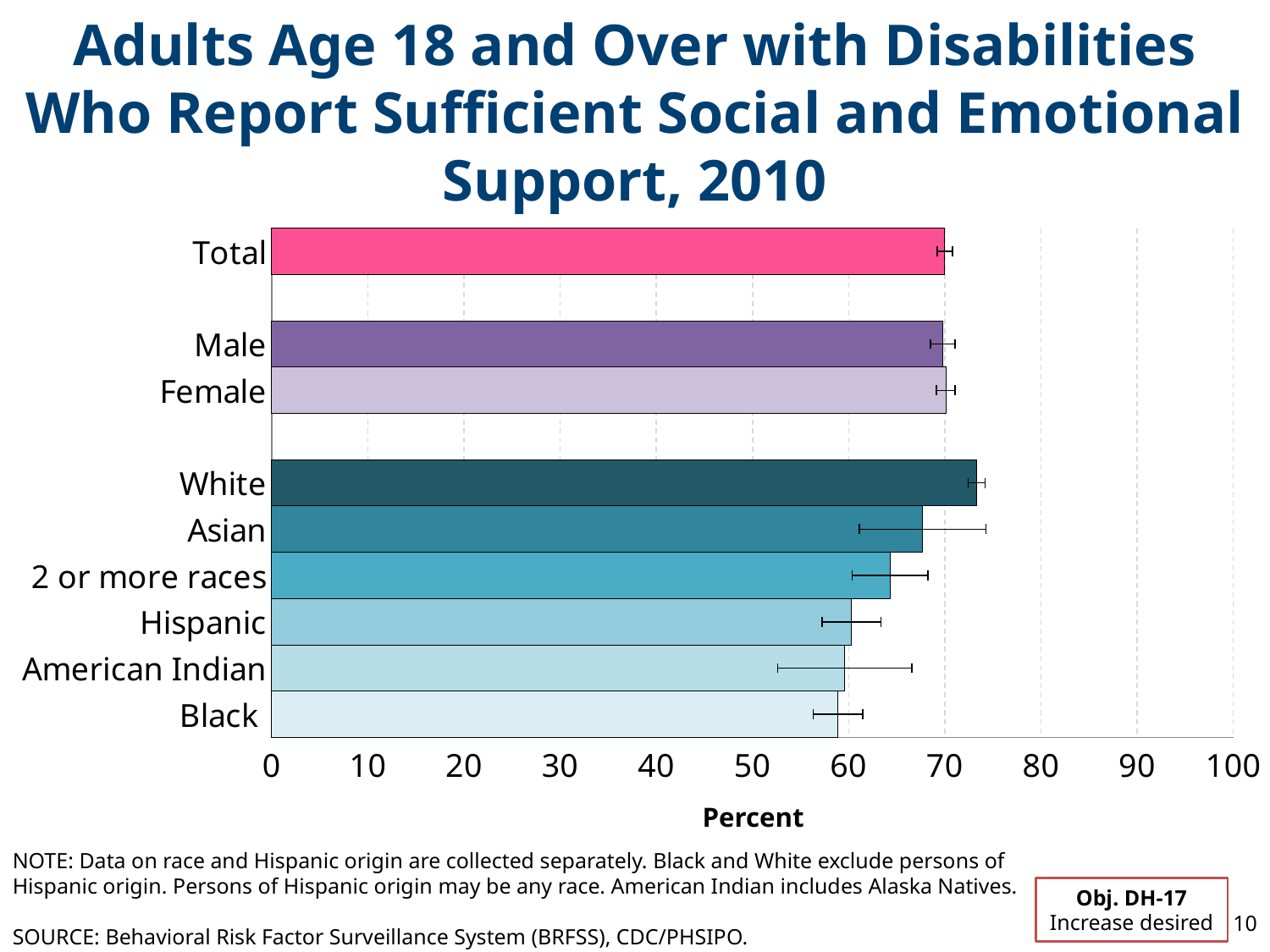
Is the value for 2 or more races greater or less than 60? greater Which is larger, the value for Asian or the value for 2 or more races? Asian How many categories (bars) are plotted in the chart? 9 Is the value for Asian greater or less than 70? less What is the label of the horizontal axis? Percent What objective number is shown in the box at the bottom right of the slide? Obj. DH-17 Is the value for Total greater or less than 60? greater Which is larger, the value for White or the value for Asian? White What kind of chart is shown on the slide? bar chart Which category has the highest value in the chart? White